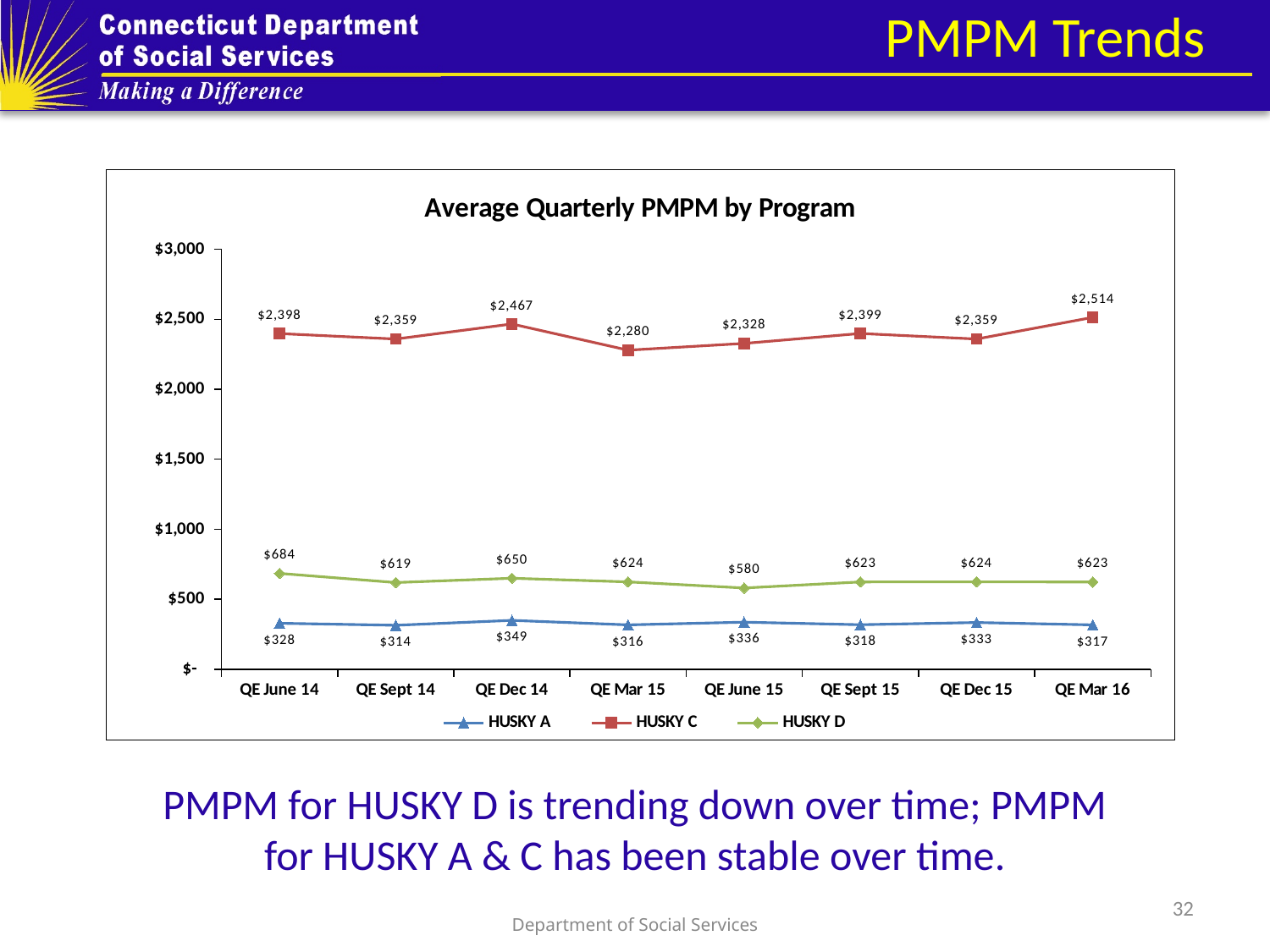
Which is larger, HUSKY C for QE Mar 15 or HUSKY C for QE June 15? QE June 15 What is the HUSKY D value for QE June 15? $580 What is the HUSKY C value for QE Dec 14? $2,467 What kind of chart is this? Line chart In which quarter is HUSKY A lowest? QE Sept 14 What is the HUSKY A value for QE Mar 16? $317 Does HUSKY C rise or fall from QE Dec 15 to QE Mar 16? Rise What is the difference between the HUSKY D values for QE June 14 and QE Mar 16? $61 How many quarters are shown on the x axis? 8 How many series does the legend list? 3 What is the title of the chart? Average Quarterly PMPM by Program In which quarter is HUSKY C highest? QE Mar 16